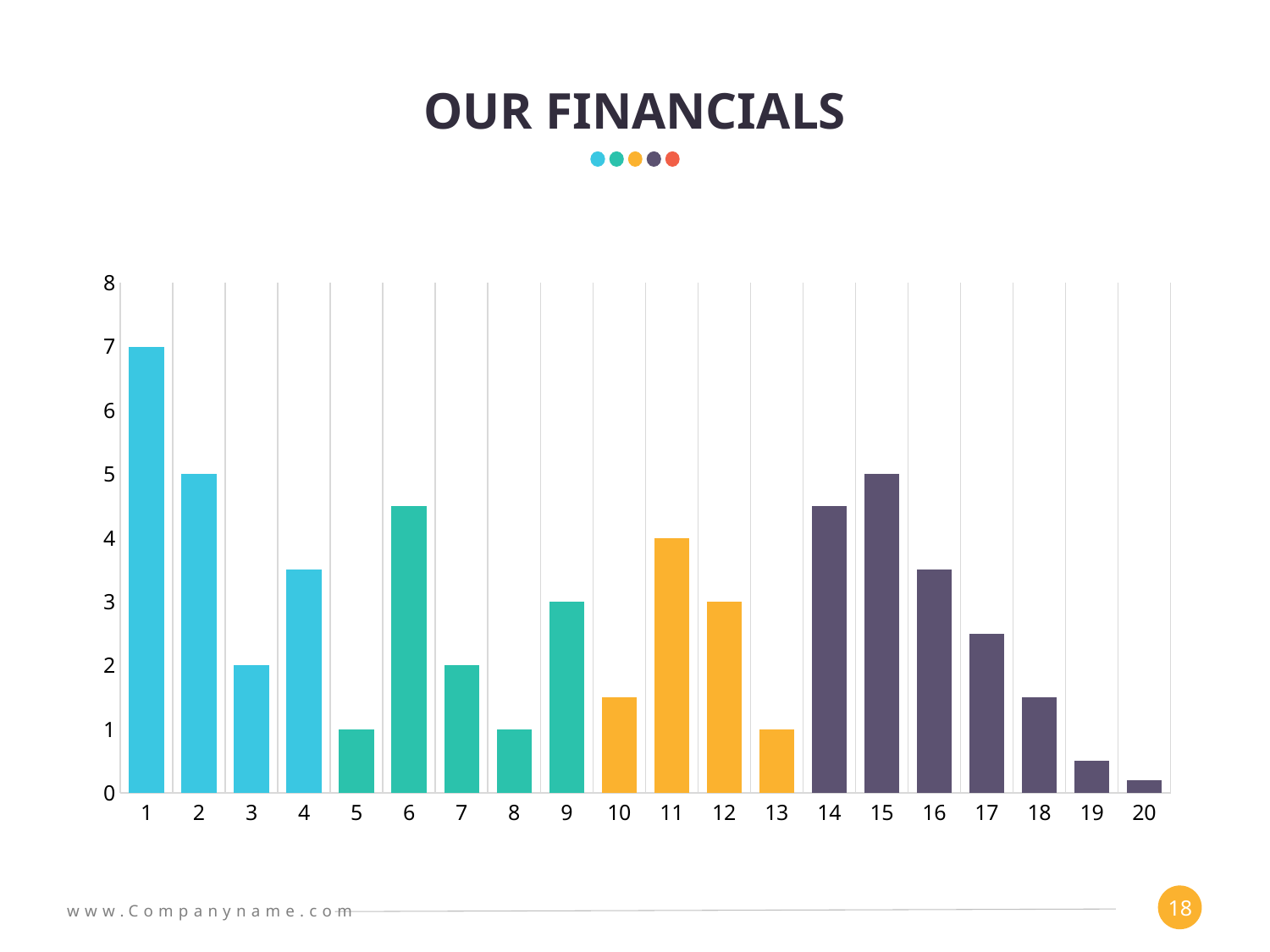
Is the value for category 19 greater or less than 1? less Is the value for category 14 greater or less than 4? greater Which category has the lowest value? 20 What is the value for category 1? 7 What is the value for category 15? 5 What type of chart is shown on the slide? bar chart Which category has the highest value? 1 What is the difference between the values for category 1 and category 2? 2 What is the title of the chart? OUR FINANCIALS What is the value for category 11? 4 How many categories are plotted on the x axis? 20 Which is larger, the value for category 6 or the value for category 7? 6